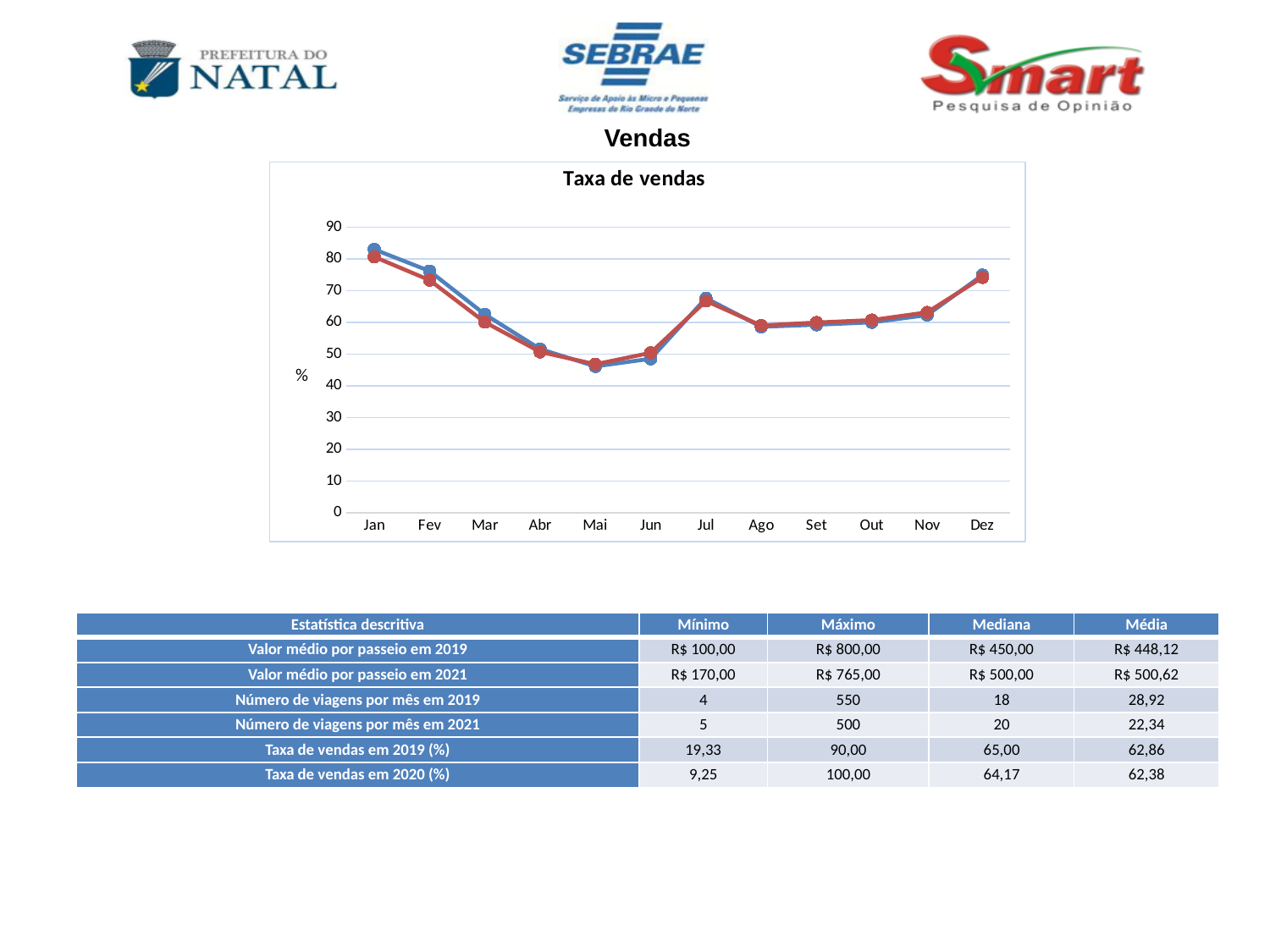
Is the value for Mai greater or less than 50? less What is the title of the chart? Taxa de vendas What is the label on the y axis of the chart? % Is the value for Dez greater or less than 70? greater Which month has a larger value, Jul or Ago? Jul Do the values rise or fall from Jan to Mai? fall How many months are plotted along the x axis of the chart? 12 Which month has the highest value in the chart? Jan Is the value for Ago greater or less than 70? less Which month has the lowest value in the chart? Mai What kind of chart is shown on the slide? line chart